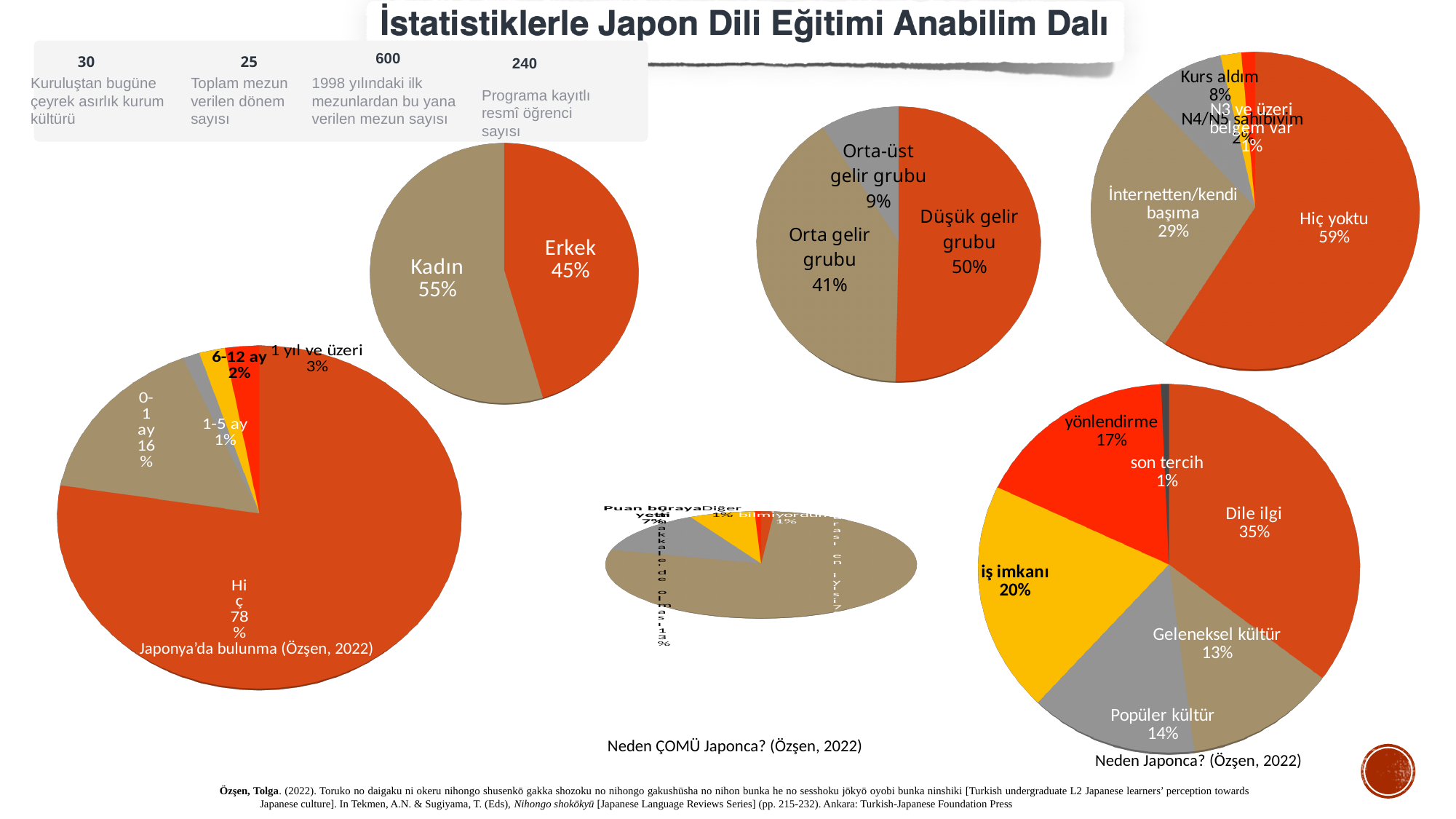
In the top-right pie chart, what is the difference between Hiç yoktu and İnternetten/kendi başıma? 30 percentage points In the gender pie chart at the top center of the slide, what percentage is labelled Kadın? 55% In the 'Japonya'da bulunma (Özşen, 2022)' pie chart, what percentage is Hiç? 78% In the 'Neden Japonca? (Özşen, 2022)' pie chart, which category has the largest share? Dile ilgi In the top-right pie chart (Hiç yoktu / İnternetten/kendi başıma / Kurs aldım), what percentage is Hiç yoktu? 59% In the income group pie chart, which category has the smallest share? Orta-üst gelir grubu In the 'Japonya'da bulunma (Özşen, 2022)' pie chart, what percentage is 1 yıl ve üzeri? 3% In the income group pie chart (Düşük/Orta/Orta-üst gelir grubu), what percentage is Orta gelir grubu? 41% What type of chart is 'Neden Japonca? (Özşen, 2022)'? Pie chart In the gender pie chart at the top center of the slide, which slice is larger, Kadın or Erkek? Kadın In the 'Neden Japonca? (Özşen, 2022)' pie chart, what percentage is iş imkanı? 20% In the income group pie chart, how many slices are there? 3